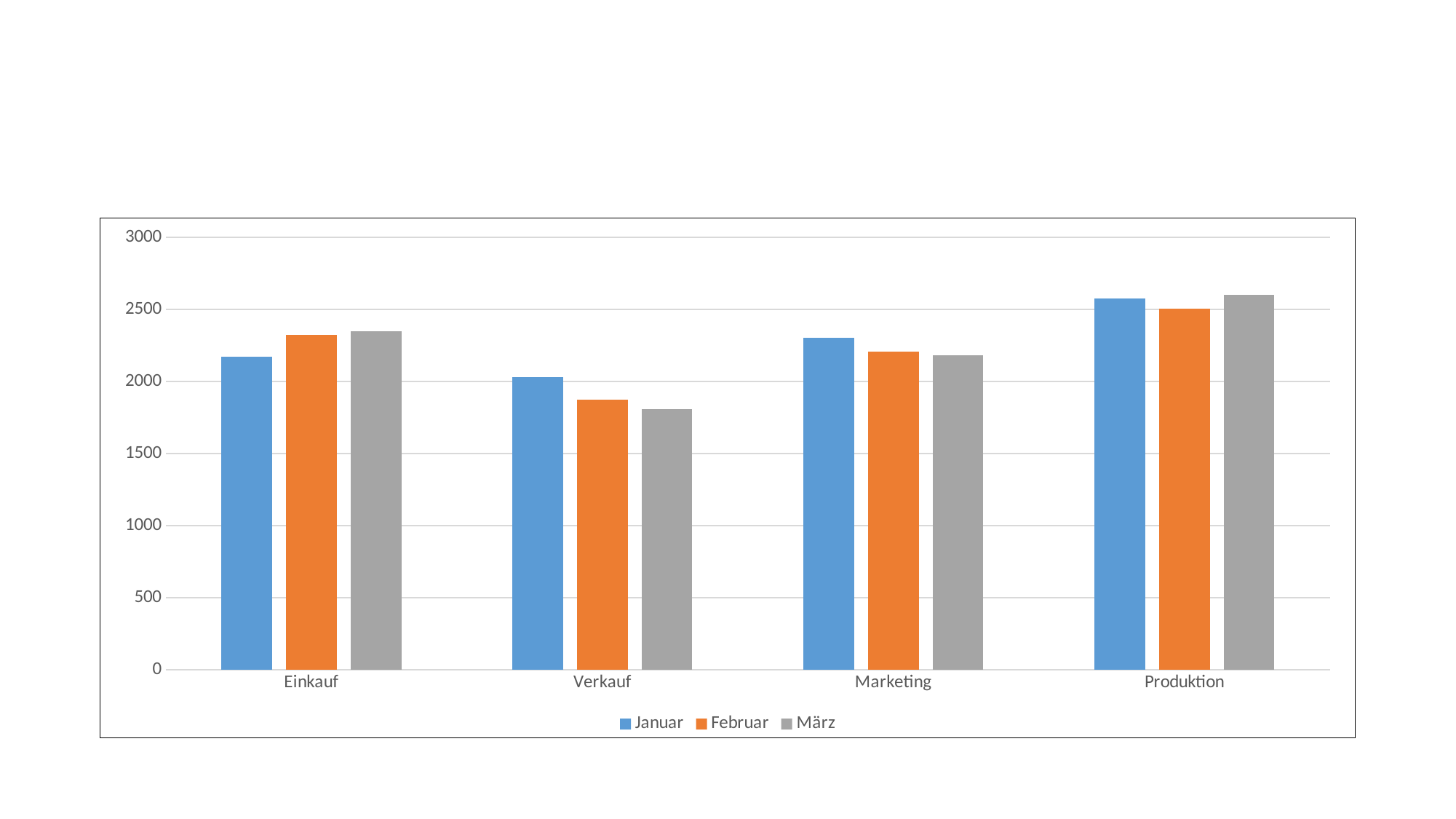
Which series is shown in orange? Februar Is the März value for Verkauf greater or less than 2000? less What kind of chart is shown on the slide? bar chart Is the Januar value for Produktion greater or less than 2500? greater How many categories are shown on the x axis? 4 For Verkauf, do the values rise or fall from Januar to März? fall Is the Januar value for Einkauf greater or less than 2000? greater Which category has the highest Februar value? Produktion For Marketing, which is larger: the Januar value or the März value? Januar For Einkauf, which is larger: the Januar value or the Februar value? Februar How many series does the legend list? 3 Which category has the lowest Februar value? Verkauf